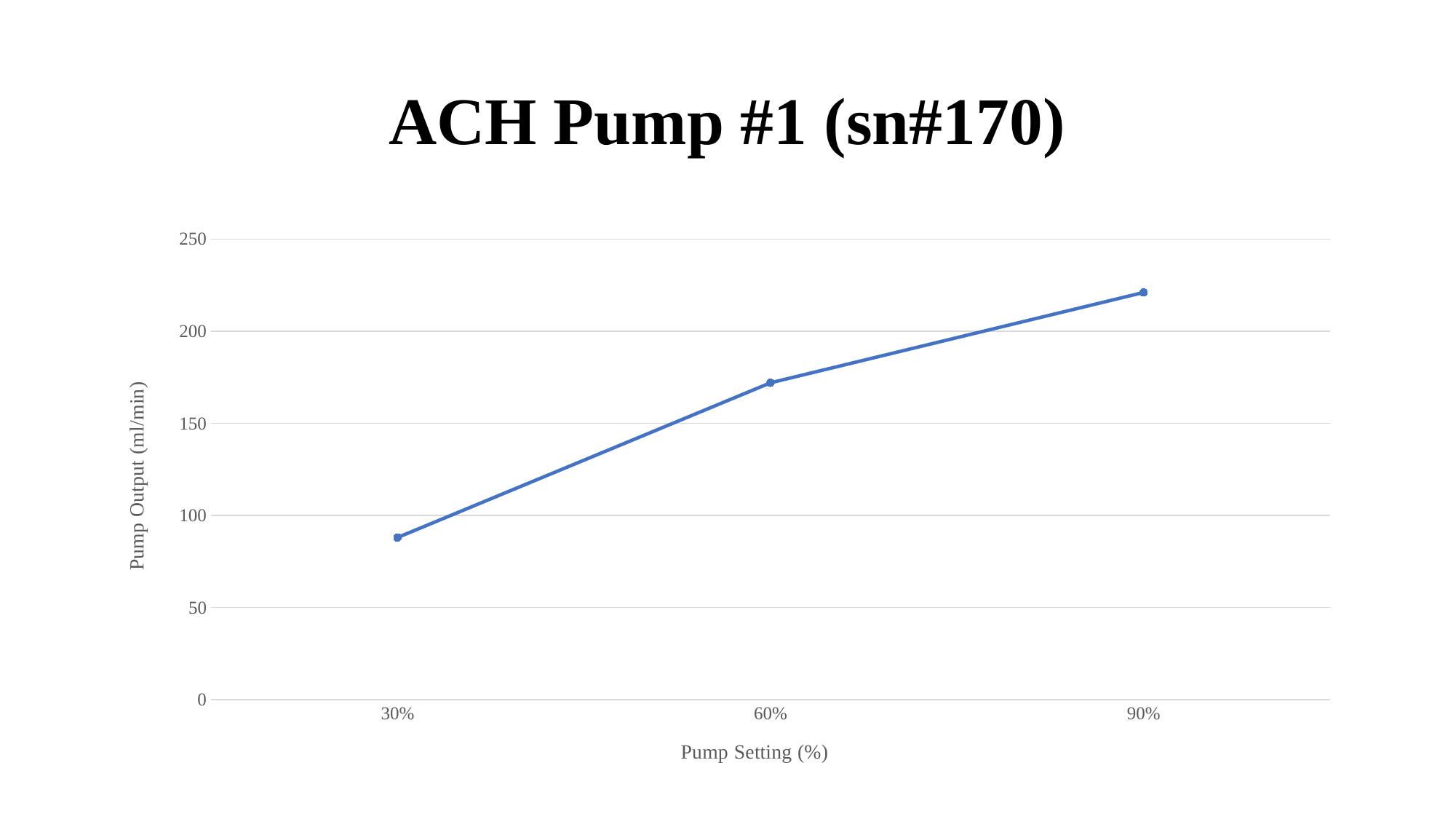
Is the pump output at the 90% setting greater or less than 200? greater What is the title of the chart? ACH Pump #1 (sn#170) Is the pump output at the 60% setting greater or less than 150? greater Is the pump output at the 60% setting greater or less than 200? less Which pump setting has the lowest pump output? 30% What is the label of the y axis? Pump Output (ml/min) Which pump setting has the highest pump output? 90% How many pump settings are plotted on the x axis? 3 Does the pump output rise or fall as the pump setting increases from 30% to 90%? rise What kind of chart is shown on the slide? line chart Which has the larger pump output, the 30% setting or the 60% setting? 60%